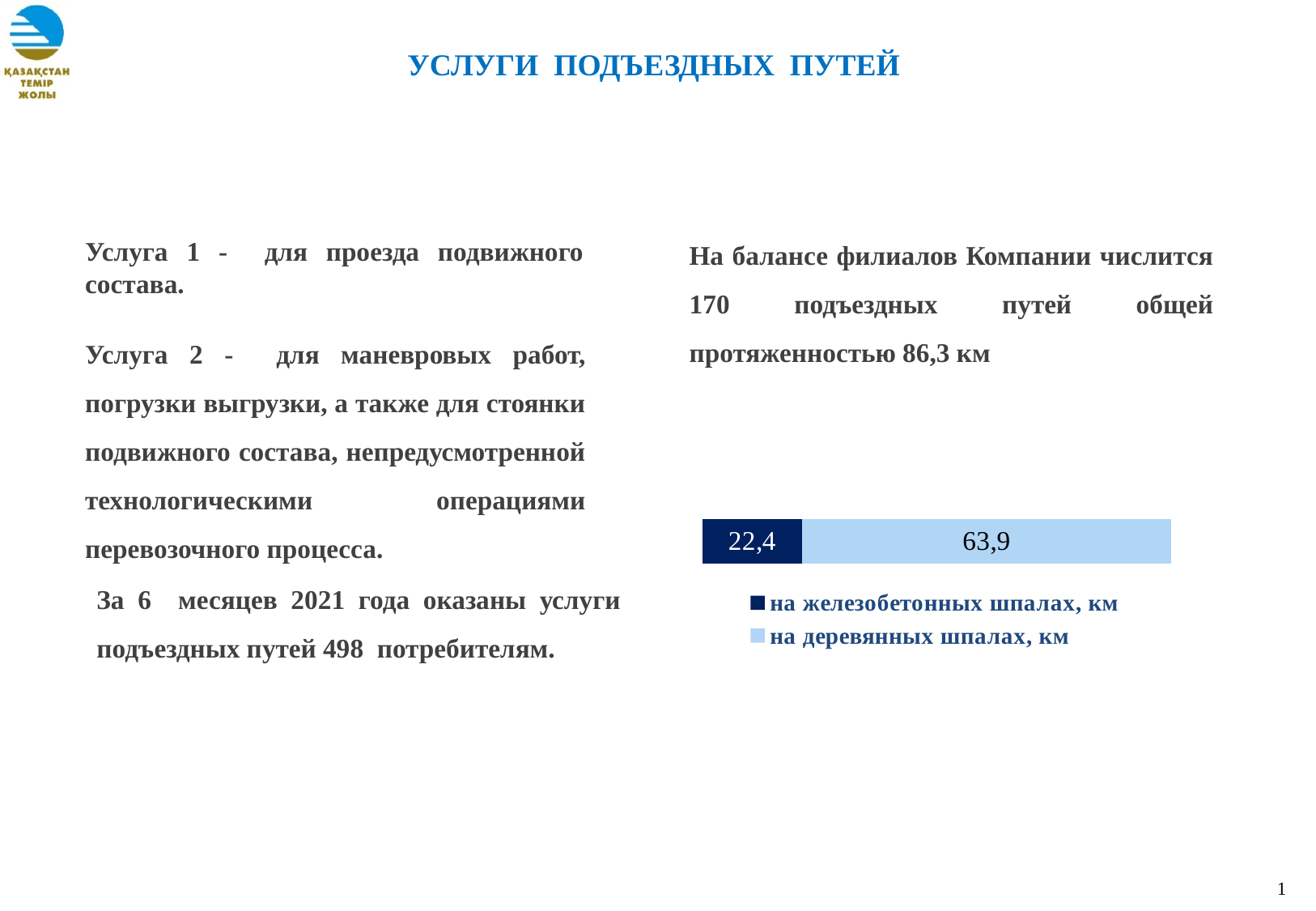
What kind of chart is shown on the slide? stacked bar chart Which series has the smallest value in the stacked bar? на железобетонных шпалах, км Which colour represents "на железобетонных шпалах, км" in the chart? dark blue What is the total of the stacked bar (sum of both segments)? 86,3 What is the value for "на деревянных шпалах, км" in the stacked bar? 63,9 What is the difference between the value for "на деревянных шпалах, км" and the value for "на железобетонных шпалах, км"? 41,5 How many bars does the chart contain? 1 Which colour represents "на деревянных шпалах, км" in the chart? light blue What is the value for "на железобетонных шпалах, км" in the stacked bar? 22,4 Which series has the largest value in the stacked bar? на деревянных шпалах, км Which series has the larger value in the stacked bar, "на железобетонных шпалах, км" or "на деревянных шпалах, км"? на деревянных шпалах, км How many series does the chart legend list? 2